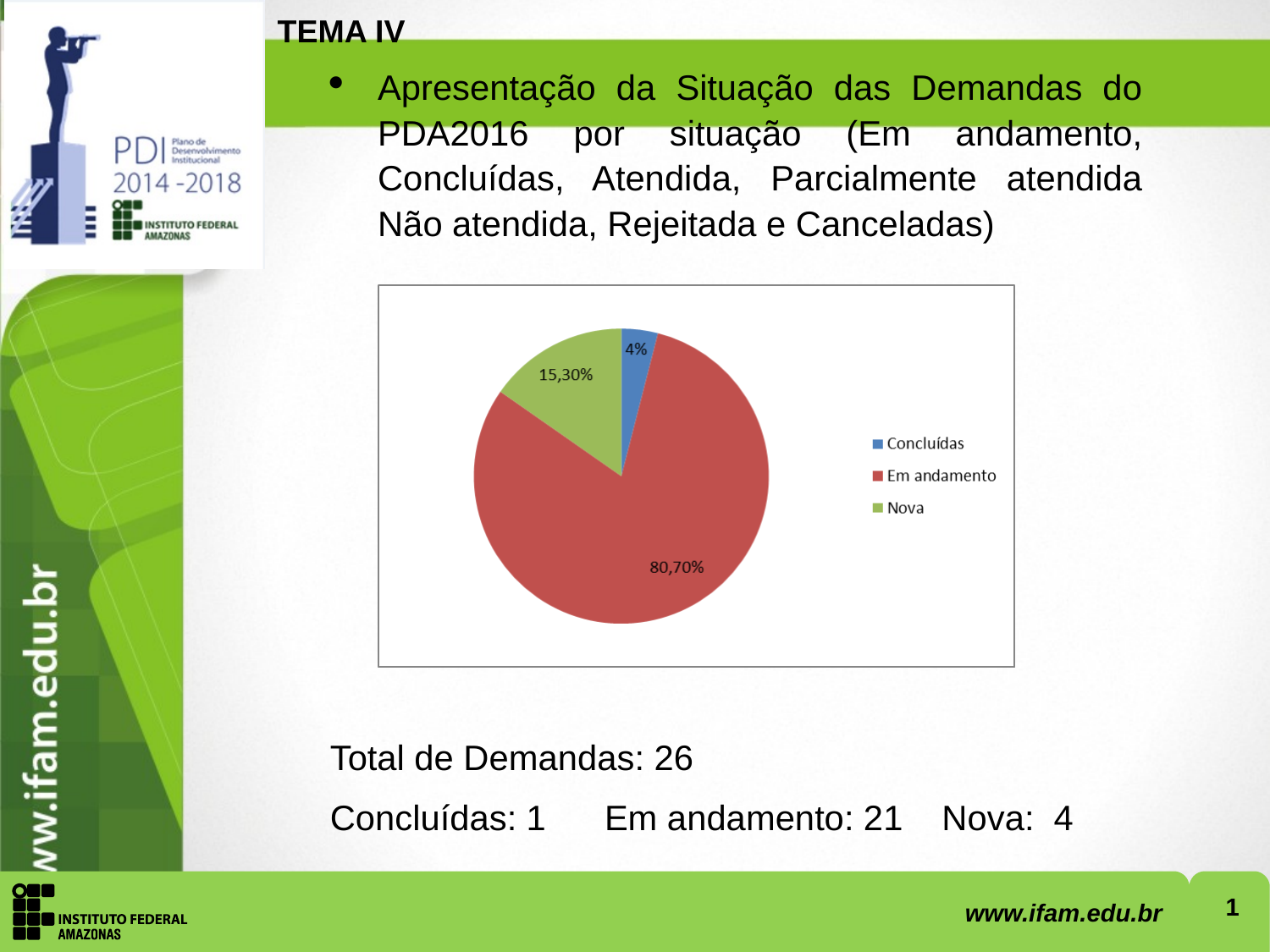
How many entries does the legend list? 3 Which category has the smallest slice of the pie? Concluídas What kind of chart is shown on the slide? pie chart What percentage of the pie does the Em andamento slice represent? 80,70% What colour is the Em andamento slice in the pie chart? red What percentage of the pie does the Nova slice represent? 15,30% Which legend entry is shown in green? Nova How many slices does the pie chart have? 3 Which slice is larger, Nova or Concluídas? Nova What is the difference in percentage points between the Em andamento slice and the Nova slice? 65,40 What percentage of the pie does the Concluídas slice represent? 4% Which category has the largest slice of the pie? Em andamento